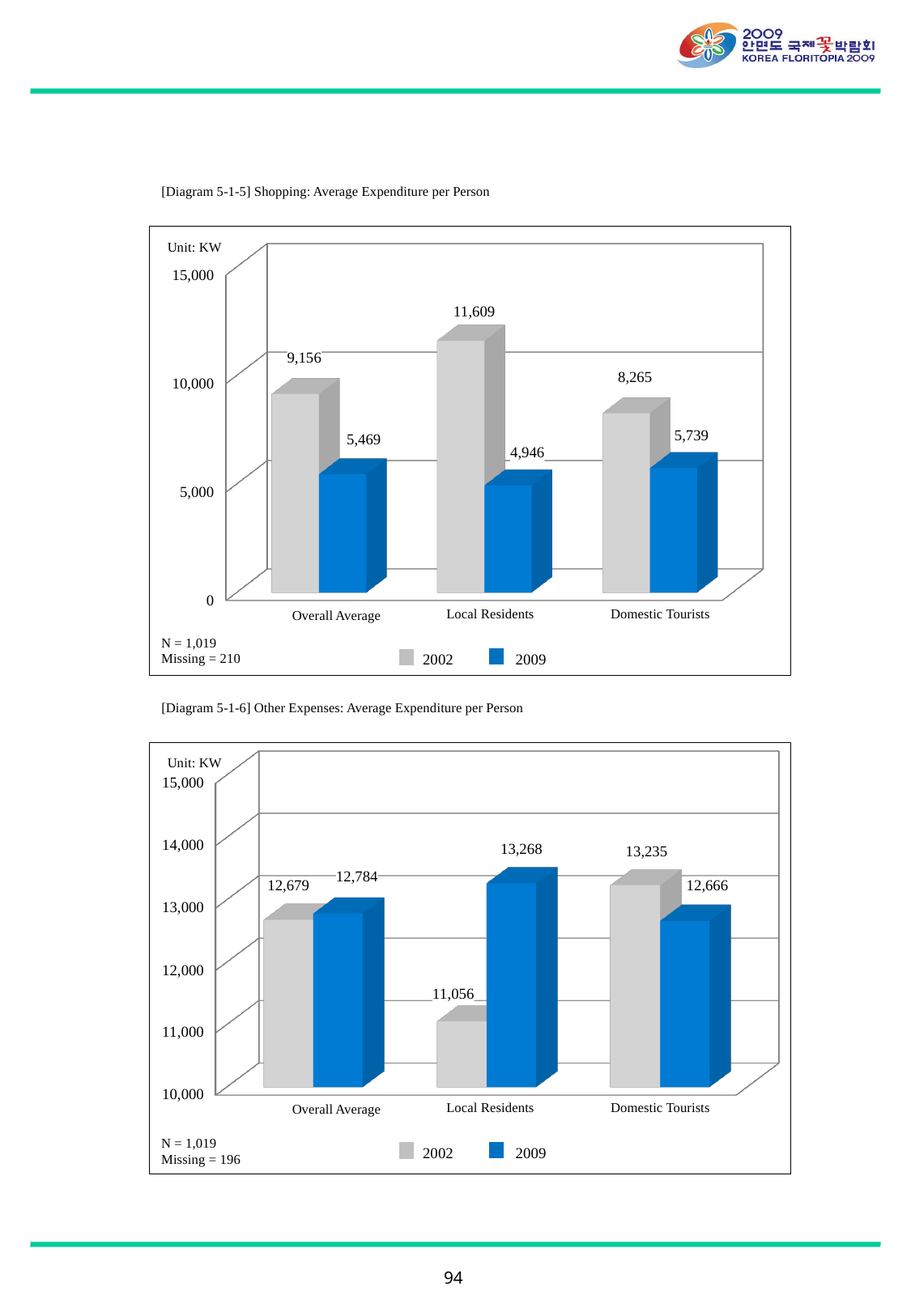
In the Other Expenses chart, what is the difference between the 2009 and 2002 values for Local Residents? 2,212 In the Other Expenses chart, which is larger for Domestic Tourists, the 2002 value or the 2009 value? 2002 In the Shopping chart, which category has the lowest 2009 value? Local Residents In the Shopping chart, what is the 2009 value for Domestic Tourists? 5,739 In the Shopping chart, is the 2002 value for Domestic Tourists greater or less than 10,000? less In the Shopping chart, what is the 2002 average expenditure per person for Local Residents? 11,609 What type of chart is the Shopping: Average Expenditure per Person chart? Bar chart In the Other Expenses chart, which category has the highest 2009 value? Local Residents How many series does the legend of the Other Expenses chart list? 2 In the Shopping chart, what is the difference between the 2002 and 2009 values for Overall Average? 3,687 How many categories are shown on the x axis of the Shopping chart? 3 In the Other Expenses chart, what is the 2002 value for Local Residents? 11,056